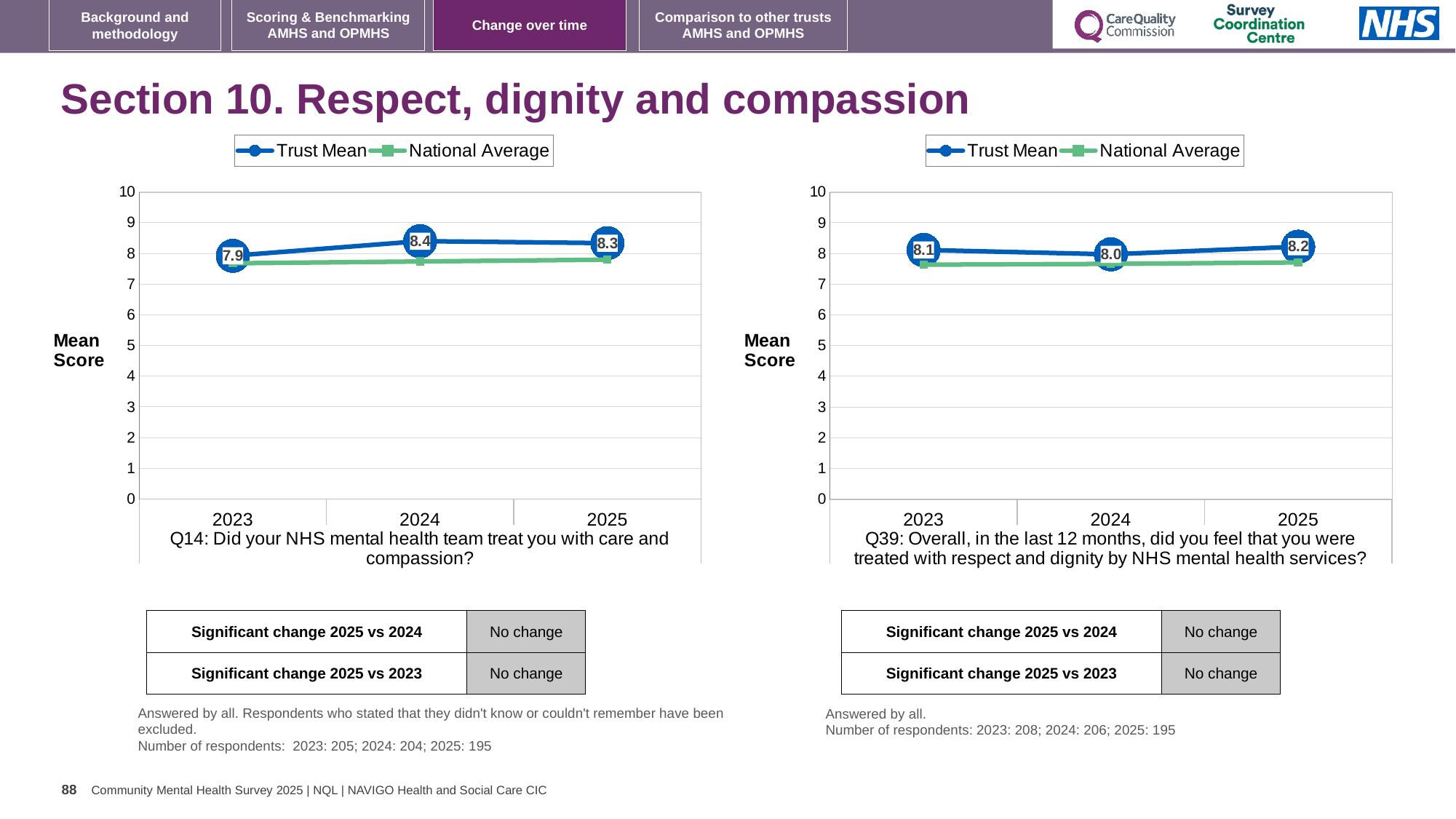
In the right chart (Q39), which year has the lowest Trust Mean? 2024 How many series does the legend of the right chart (Q39) list? 2 In the left chart (Q14), is the National Average for 2023 greater or less than 8? less In the left chart (Q14), which year has the highest Trust Mean? 2024 In the left chart (Q14), what is the Trust Mean for 2024? 8.4 In the right chart (Q39), what is the Trust Mean for 2024? 8.0 In the right chart (Q39), what is the Trust Mean for 2025? 8.2 What type of chart is the left chart (Q14)? line chart In the left chart (Q14), what is the difference between the Trust Mean for 2024 and 2023? 0.5 In the right chart (Q39), is the Trust Mean for 2025 larger or smaller than the Trust Mean for 2023? larger How many years are plotted on the x axis of the right chart (Q39)? 3 In the left chart (Q14), what is the Trust Mean for 2023? 7.9